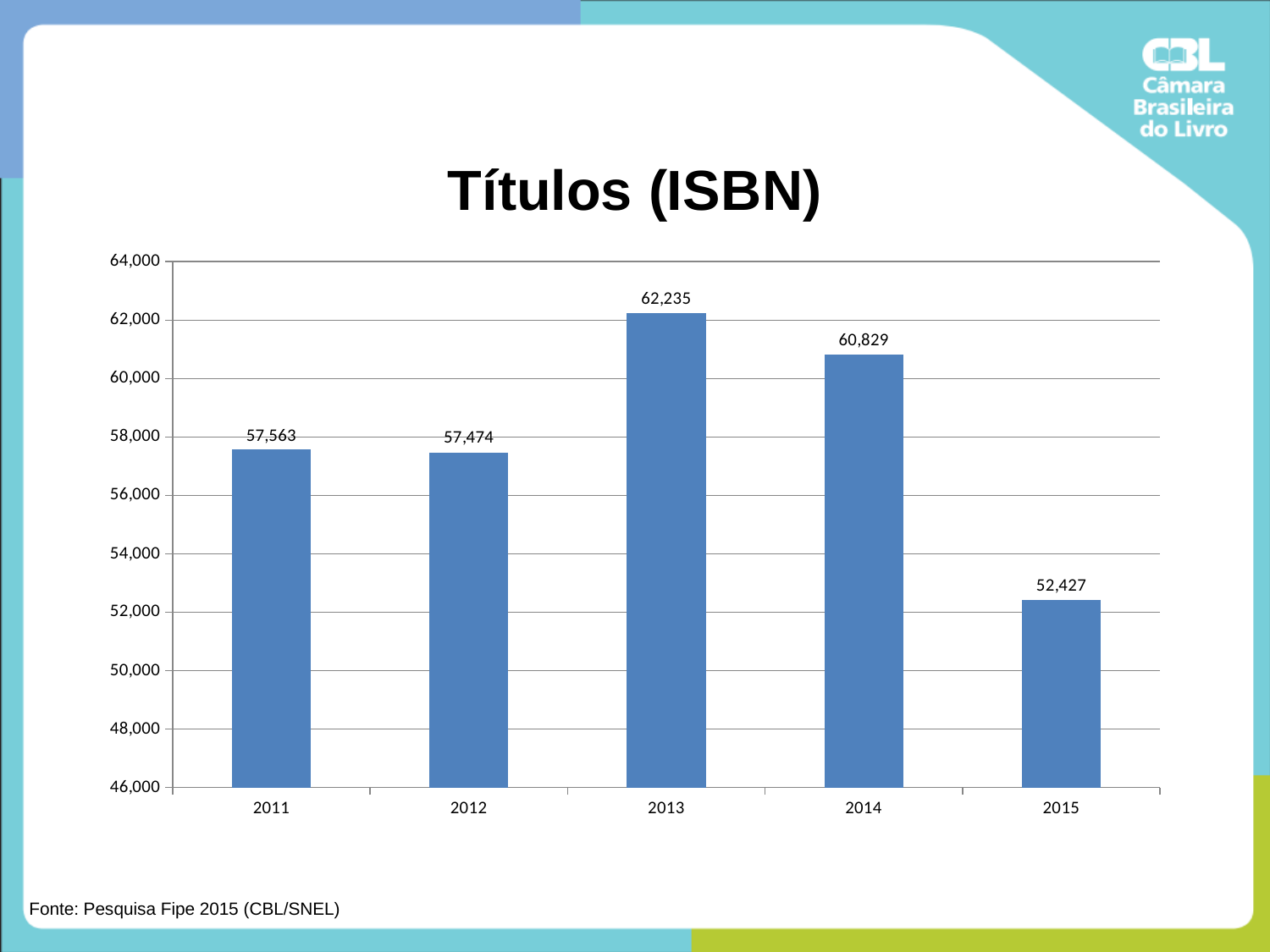
What is the difference between the values for 2011 and 2012? 89 Which year has the lowest value? 2015 What is the difference between the values for 2013 and 2014? 1,406 How many years are shown on the x axis? 5 Is the value for 2014 greater or less than 60,000? greater What kind of chart is shown on the slide? bar chart What is the value for 2015? 52,427 What is the value for 2011? 57,563 What is the title of the chart? Títulos (ISBN) What is the value for 2013? 62,235 Which is larger, the value for 2014 or the value for 2015? 2014 Which year has the highest value? 2013